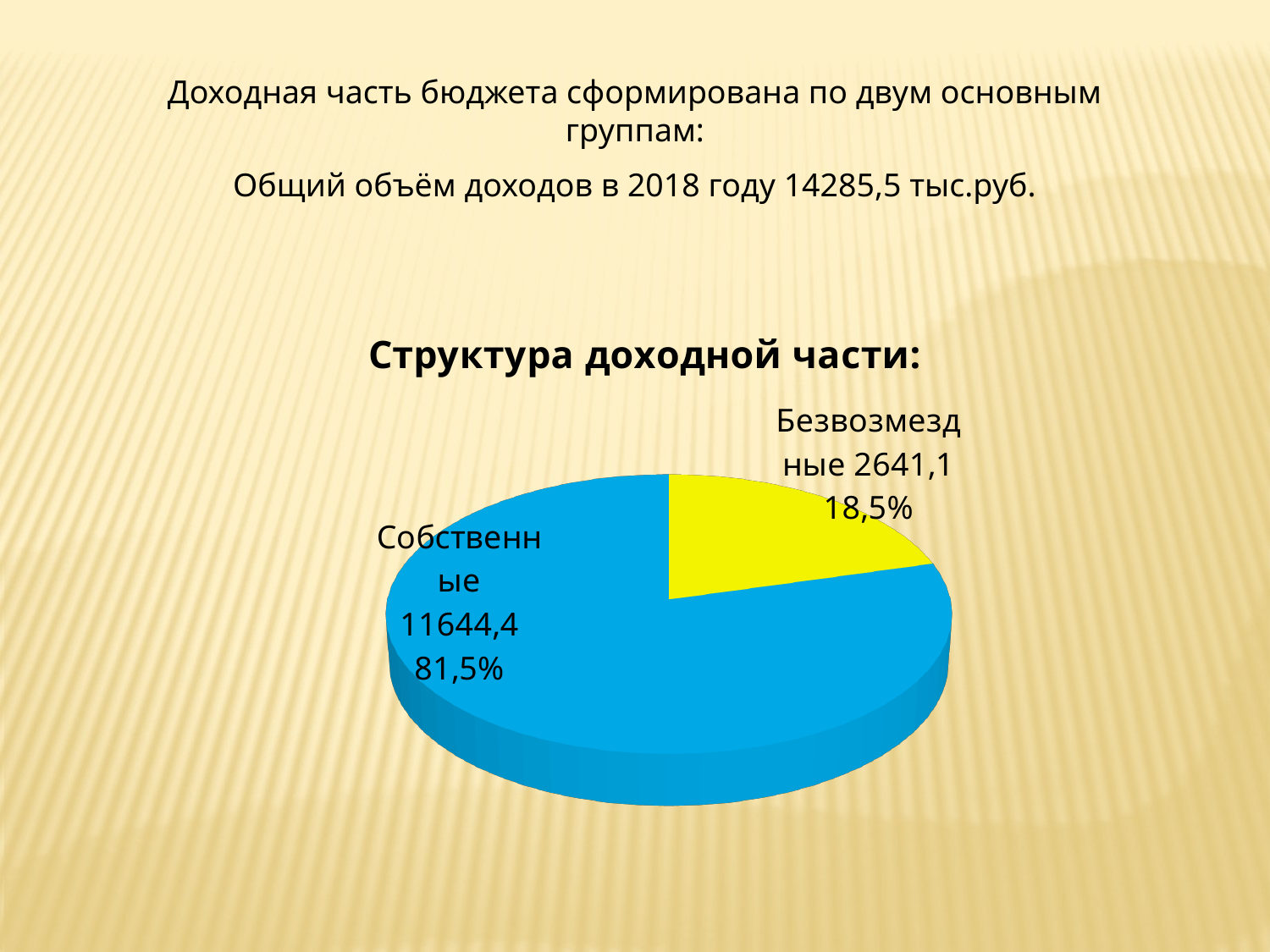
What is the difference between the values for Собственные and Безвозмездные? 9003,3 Which category has the largest slice? Собственные What is the title of the chart? Структура доходной части: How many slices does the pie chart have? 2 Which category has the smallest slice? Безвозмездные What is the value shown for Безвозмездные? 2641,1 What is the value shown for Собственные? 11644,4 What share of the pie does Собственные represent? 81,5% What colour is the Безвозмездные slice? Yellow What share of the pie does Безвозмездные represent? 18,5% Which is larger, Собственные or Безвозмездные? Собственные What type of chart is shown on the slide? Pie chart